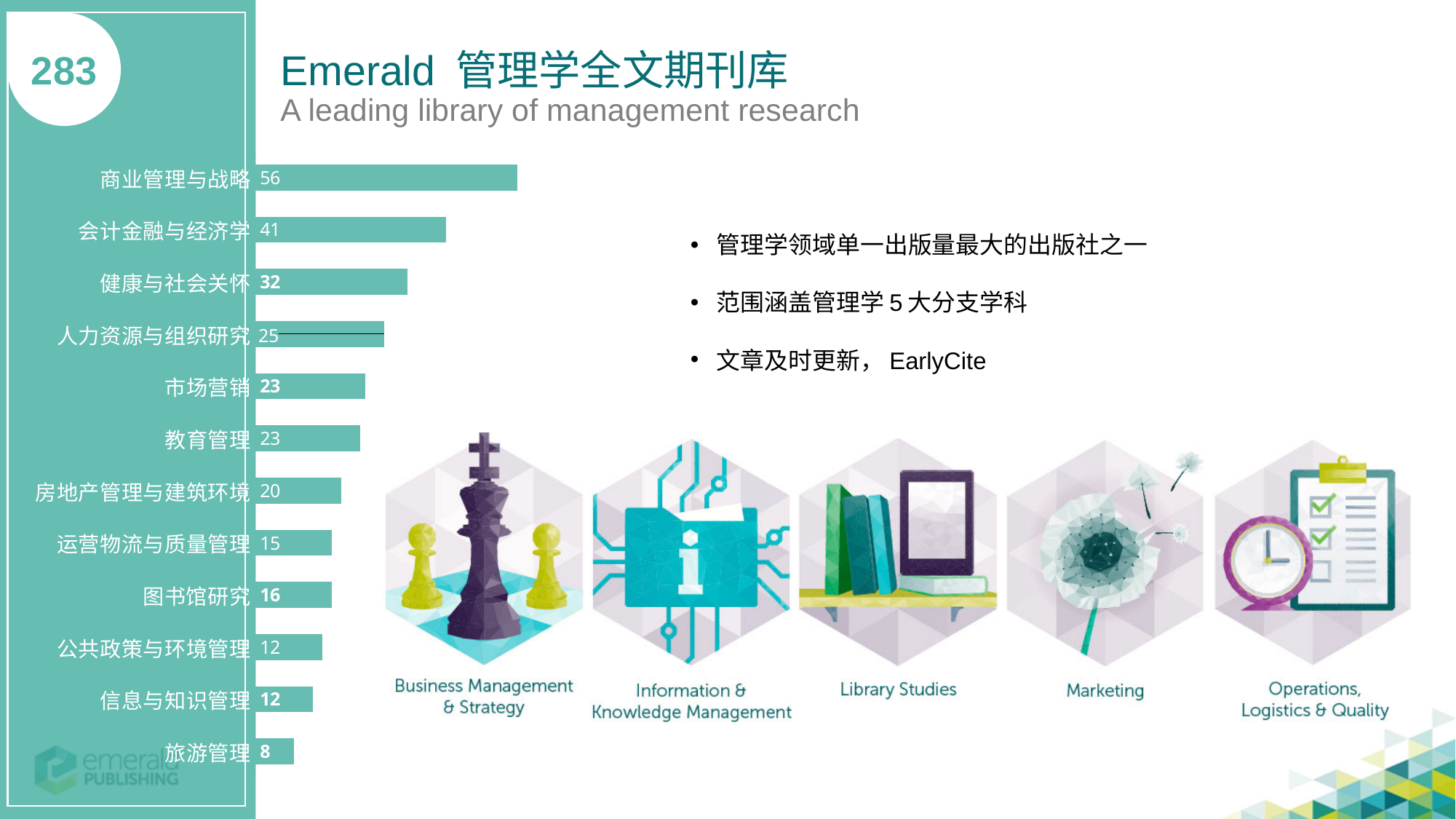
What is the difference between the values for 健康与社会关怀 and 人力资源与组织研究? 7 What is the value for 商业管理与战略? 56 What is the difference between the values for 商业管理与战略 and 会计金融与经济学? 15 What is the value for 图书馆研究? 16 What is the value for 会计金融与经济学? 41 Which category has the lowest value? 旅游管理 Which is larger, the value for 图书馆研究 or the value for 运营物流与质量管理? 图书馆研究 Which category has the highest value? 商业管理与战略 What kind of chart is shown on the slide? bar chart How many categories does the bar chart show? 12 What is the value for 旅游管理? 8 What is the sum of the values for 公共政策与环境管理 and 信息与知识管理? 24